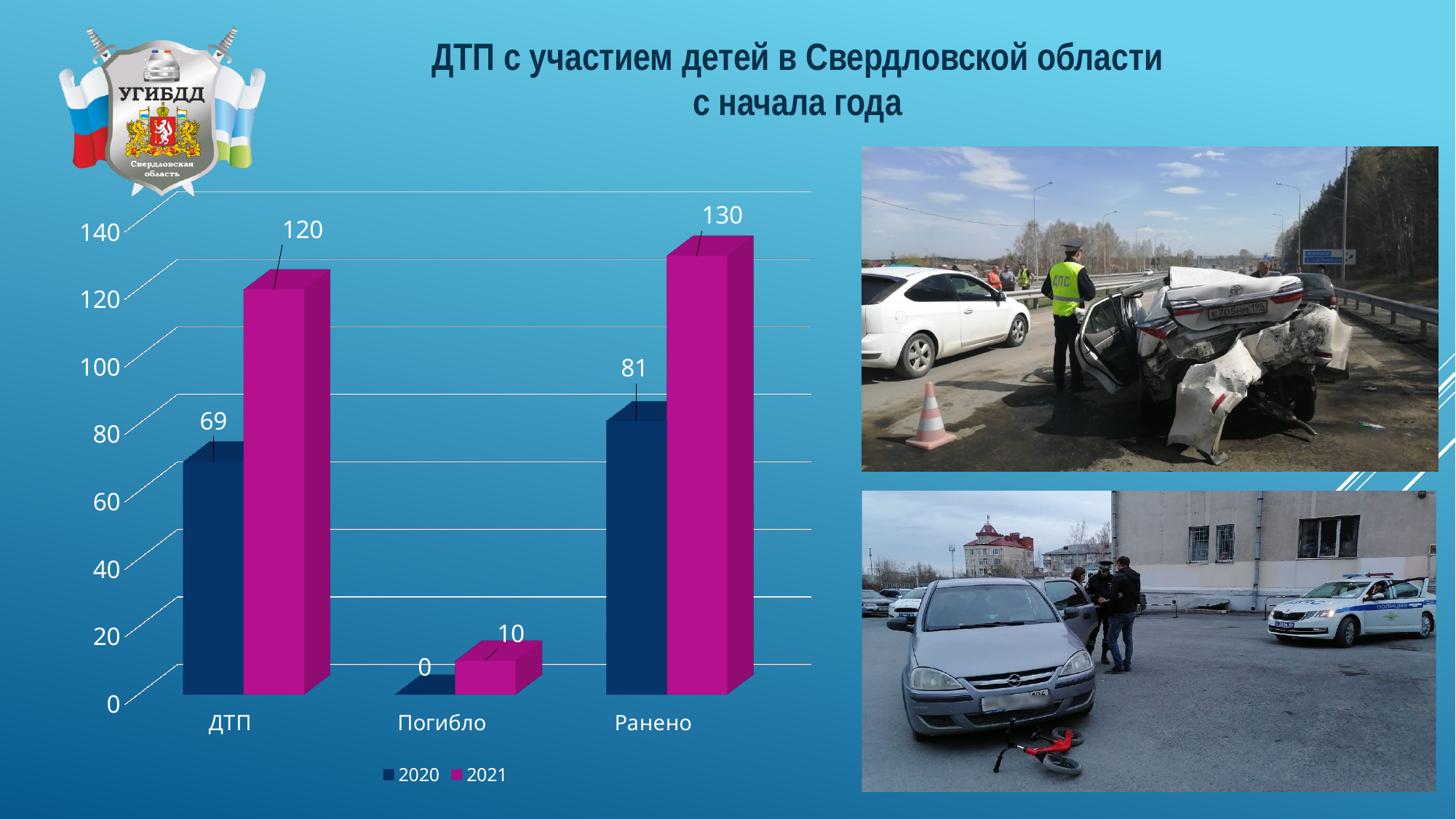
What is the value for Погибло in the 2021 series? 10 Which category has the highest value in the 2021 series? Ранено What is the value for Ранено in the 2020 series? 81 Which is larger: the 2020 value for ДТП or the 2020 value for Ранено? Ранено What is the value for Погибло in the 2020 series? 0 How many categories are shown on the x axis? 3 Which category has the lowest value in the 2020 series? Погибло What kind of chart is shown on the slide? Bar chart What is the value for ДТП in the 2021 series? 120 What is the difference between the 2021 and 2020 values for Ранено? 49 What is the difference between the 2021 and 2020 values for ДТП? 51 How many series does the legend list? 2